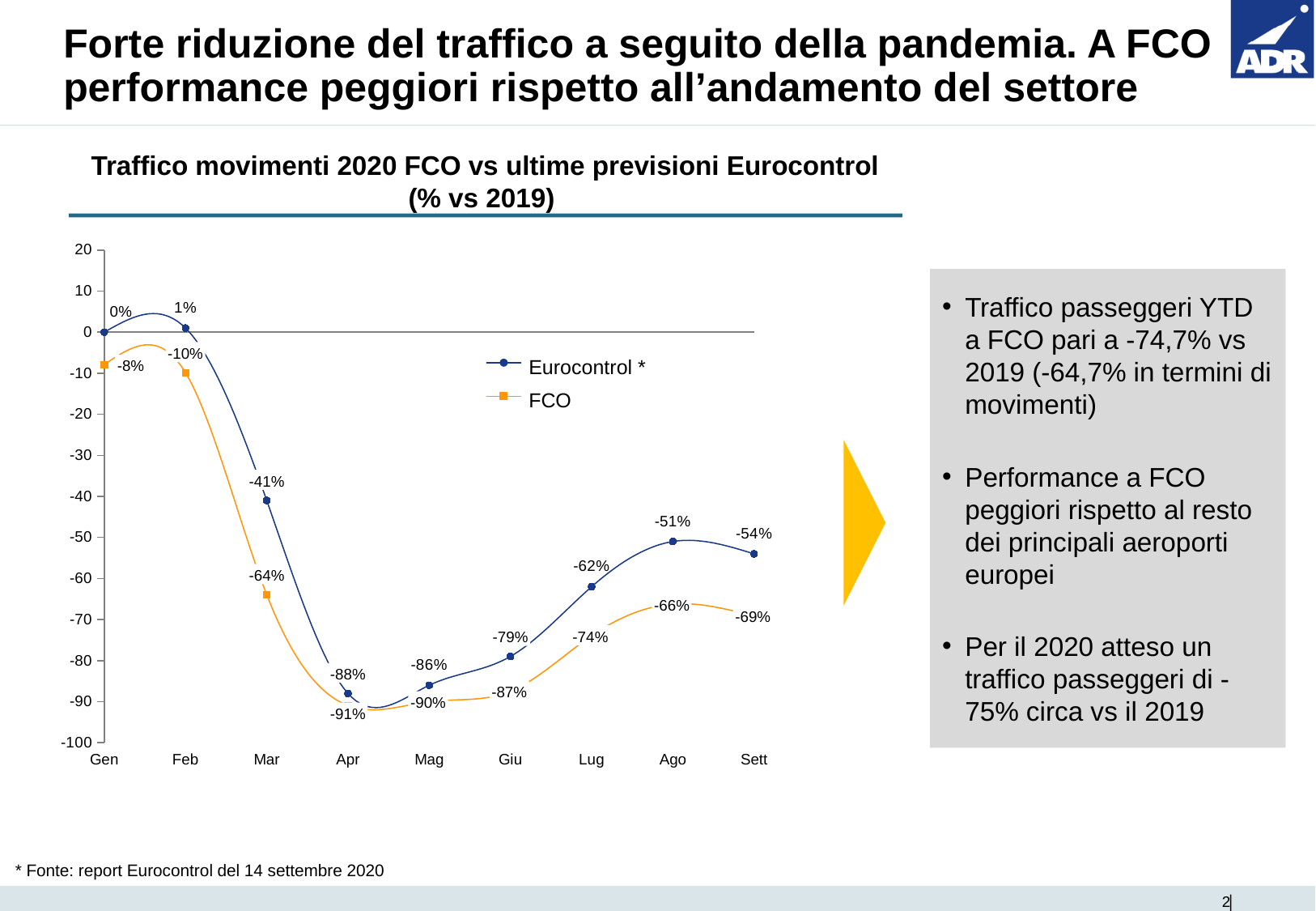
In which month does the Eurocontrol series reach its highest value? Feb How many months are shown on the x axis? 9 What is the difference in percentage points between the Eurocontrol value and the FCO value in Mar? 23 percentage points Does the Eurocontrol series rise or fall from Apr to Ago? Rise How many series does the legend list? 2 What kind of chart is shown on the slide? Line chart What are the two series named in the legend? Eurocontrol * and FCO What is the Eurocontrol value for Mar? -41% What is the FCO value for Apr? -91% In Ago, which series has the higher value, Eurocontrol or FCO? Eurocontrol What is the FCO value for Sett? -69% In which month does the FCO series reach its lowest value? Apr